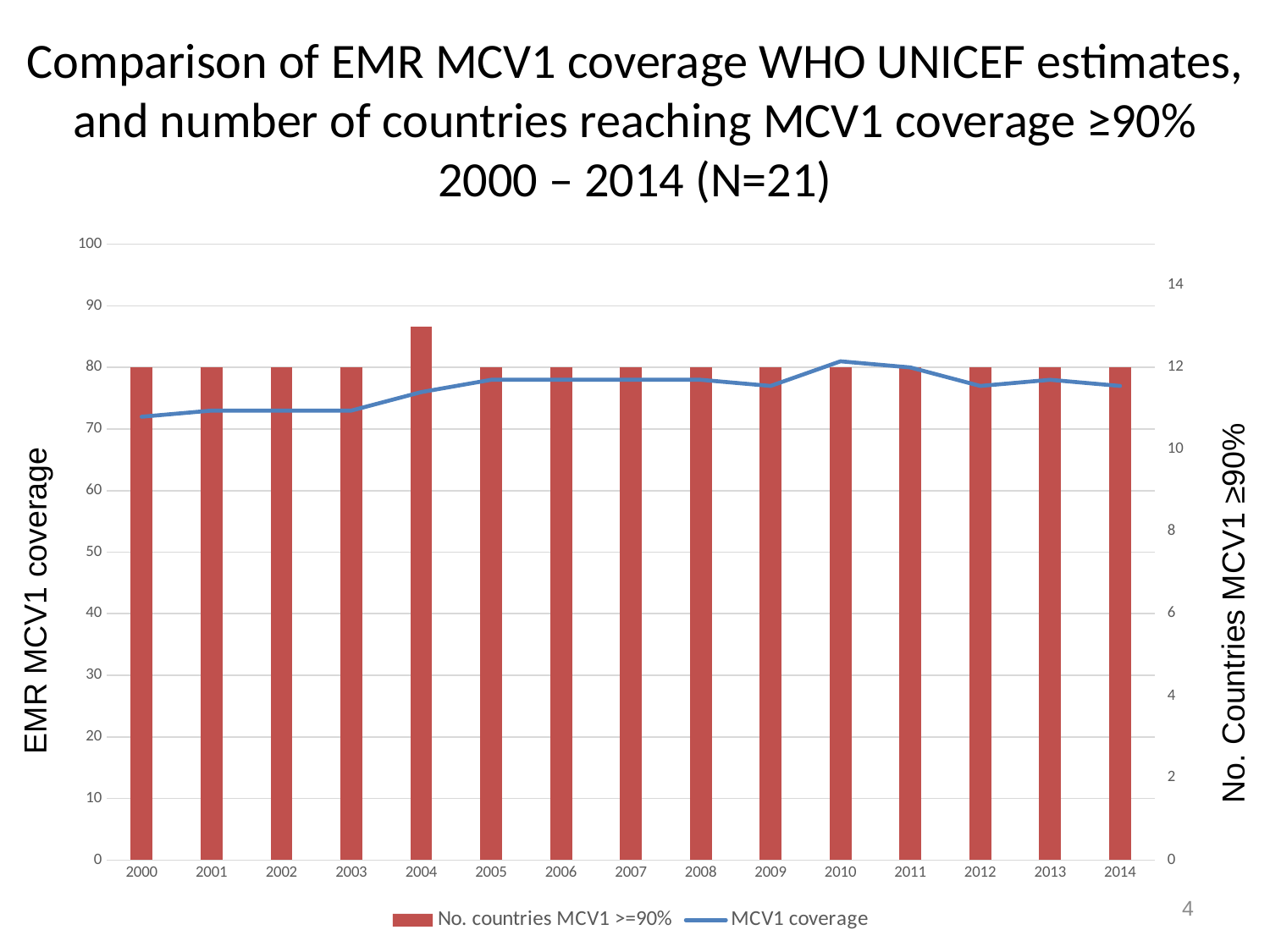
What kind of chart is shown on the slide? A combined bar and line chart Is the MCV1 coverage value for 2000 greater or less than 70? greater How many years are shown along the x axis? 15 What is the title of the left-hand vertical axis? EMR MCV1 coverage What is the value of the No. countries MCV1 >=90% bar for 2000 on the right-hand axis? 12 Which year has the higher MCV1 coverage value, 2000 or 2010? 2010 Is the No. countries MCV1 >=90% bar for 2004 greater or less than 12 on the right-hand axis? greater Is the MCV1 coverage value for 2000 greater or less than 80? less Does the MCV1 coverage line rise or fall from 2000 to 2005? rise What are the two entries in the chart legend? No. countries MCV1 >=90% and MCV1 coverage How many series does the legend list? 2 In which year is the bar for No. countries MCV1 >=90% highest? 2004